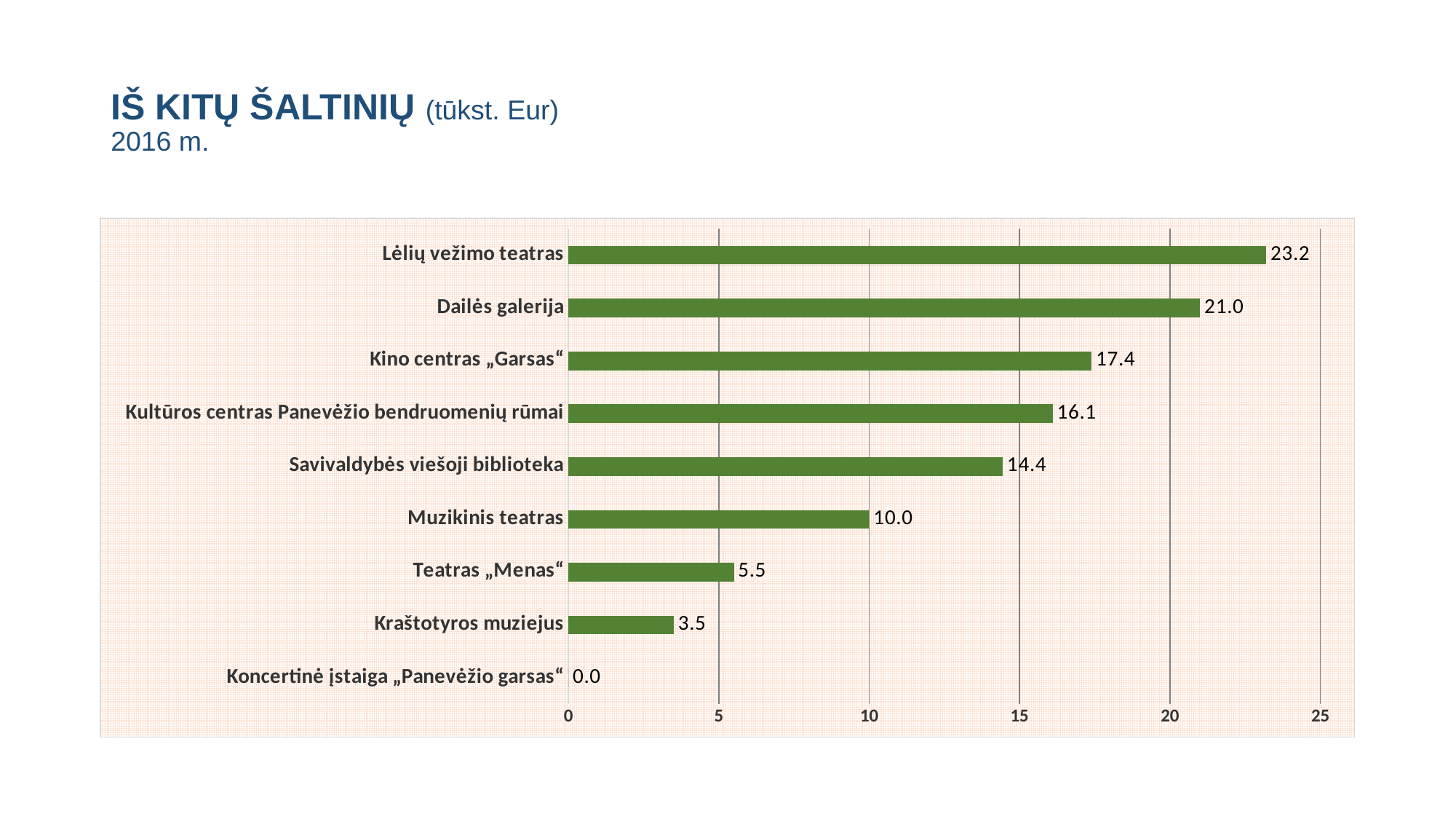
What colour are the bars in the chart? green What is the value for Kraštotyros muziejus? 3.5 What is the value for Savivaldybės viešoji biblioteka? 14.4 Which category has the highest value? Lėlių vežimo teatras What is the value for Lėlių vežimo teatras? 23.2 How many categories are shown in the chart? 9 What is the difference between the values for Dailės galerija and Kino centras „Garsas“? 3.6 What kind of chart is shown on the slide? bar chart Which is larger, the value for Muzikinis teatras or the value for Teatras „Menas“? Muzikinis teatras Which category has the lowest value? Koncertinė įstaiga „Panevėžio garsas“ What is the title of the slide? IŠ KITŲ ŠALTINIŲ (tūkst. Eur) 2016 m. Is the value for Kultūros centras Panevėžio bendruomenių rūmai greater or less than 15? greater